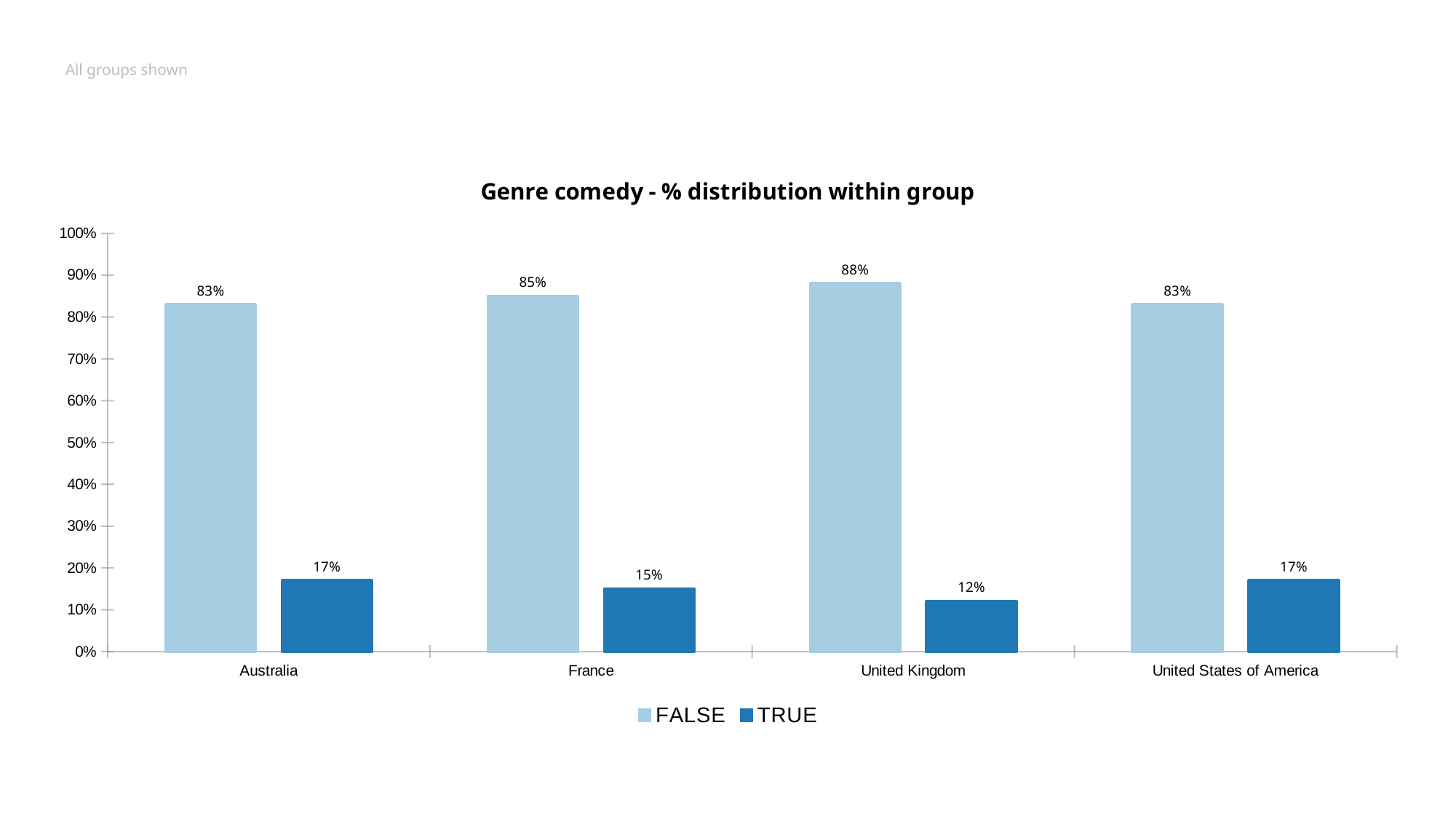
What is the title of the chart? Genre comedy - % distribution within group How many series does the legend list? 2 What kind of chart is shown? bar chart Is the TRUE value for France larger or smaller than the TRUE value for United Kingdom? larger How many countries are shown on the x axis? 4 What is the TRUE value for United Kingdom? 12% What is the difference between the FALSE and TRUE values for France? 70% Which country has the highest FALSE value? United Kingdom What is the TRUE value for Australia? 17% What is the FALSE value for France? 85% Is the FALSE value for United States of America greater or less than 80%? greater Which country has the lowest TRUE value? United Kingdom